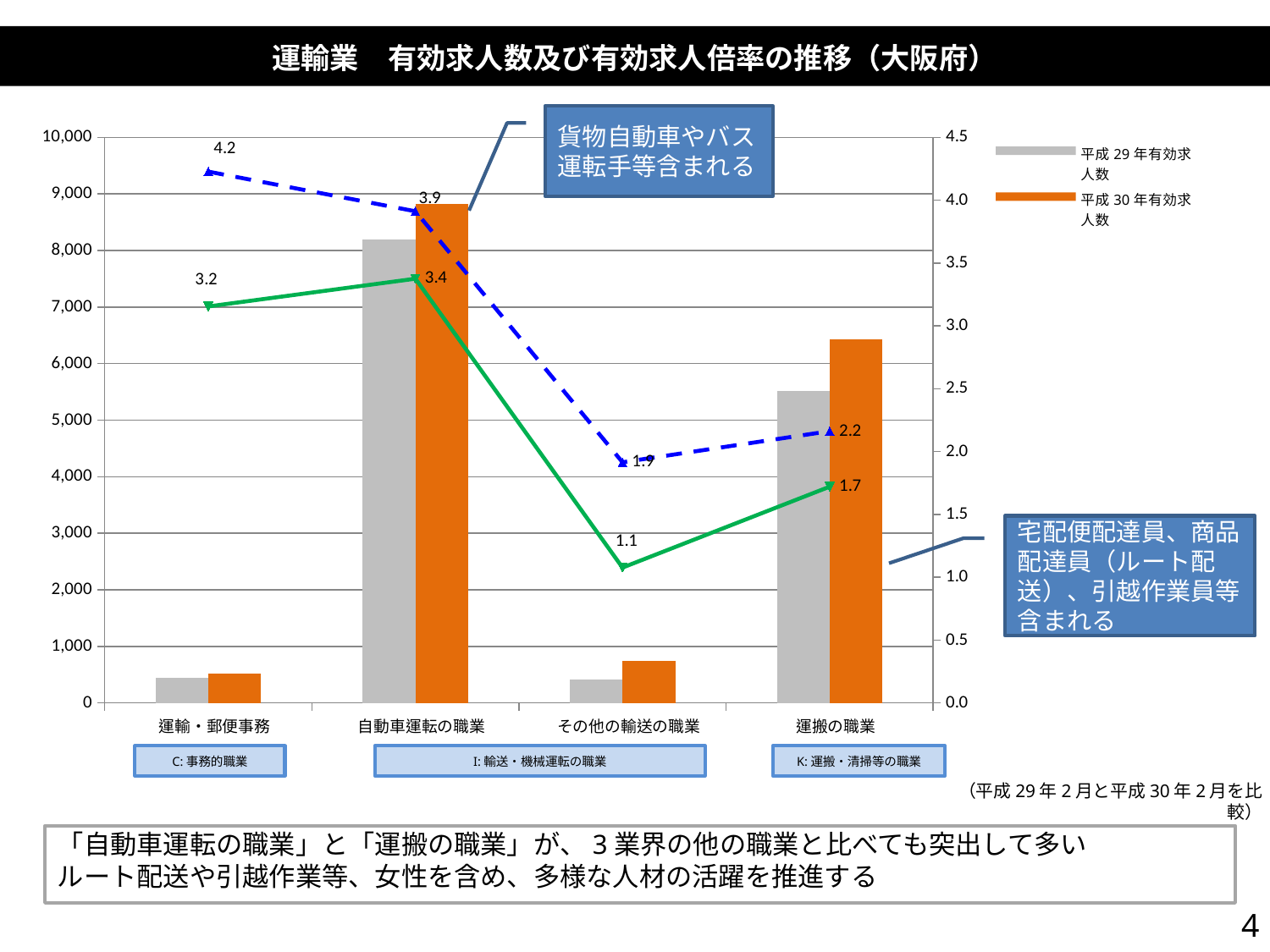
What is the value of the blue dashed line for 運搬の職業? 2.2 How many occupation categories are shown on the x axis? 4 What is the value of the green solid line for その他の輸送の職業? 1.1 Which category has the tallest 平成30年有効求人数 bar? 自動車運転の職業 For which category is the blue dashed line lowest? その他の輸送の職業 How many series does the legend list? 2 For which category is the green solid line highest? 自動車運転の職業 What kind of chart is shown on the slide? A combination bar and line chart What is the difference between the blue dashed line value and the green solid line value for 運輸・郵便事務? 1.0 What is the value of the blue dashed line for 運輸・郵便事務? 4.2 Is the 平成30年有効求人数 value for 運搬の職業 greater or less than 6,000? greater What is the title of the chart? 運輸業 有効求人数及び有効求人倍率の推移（大阪府）